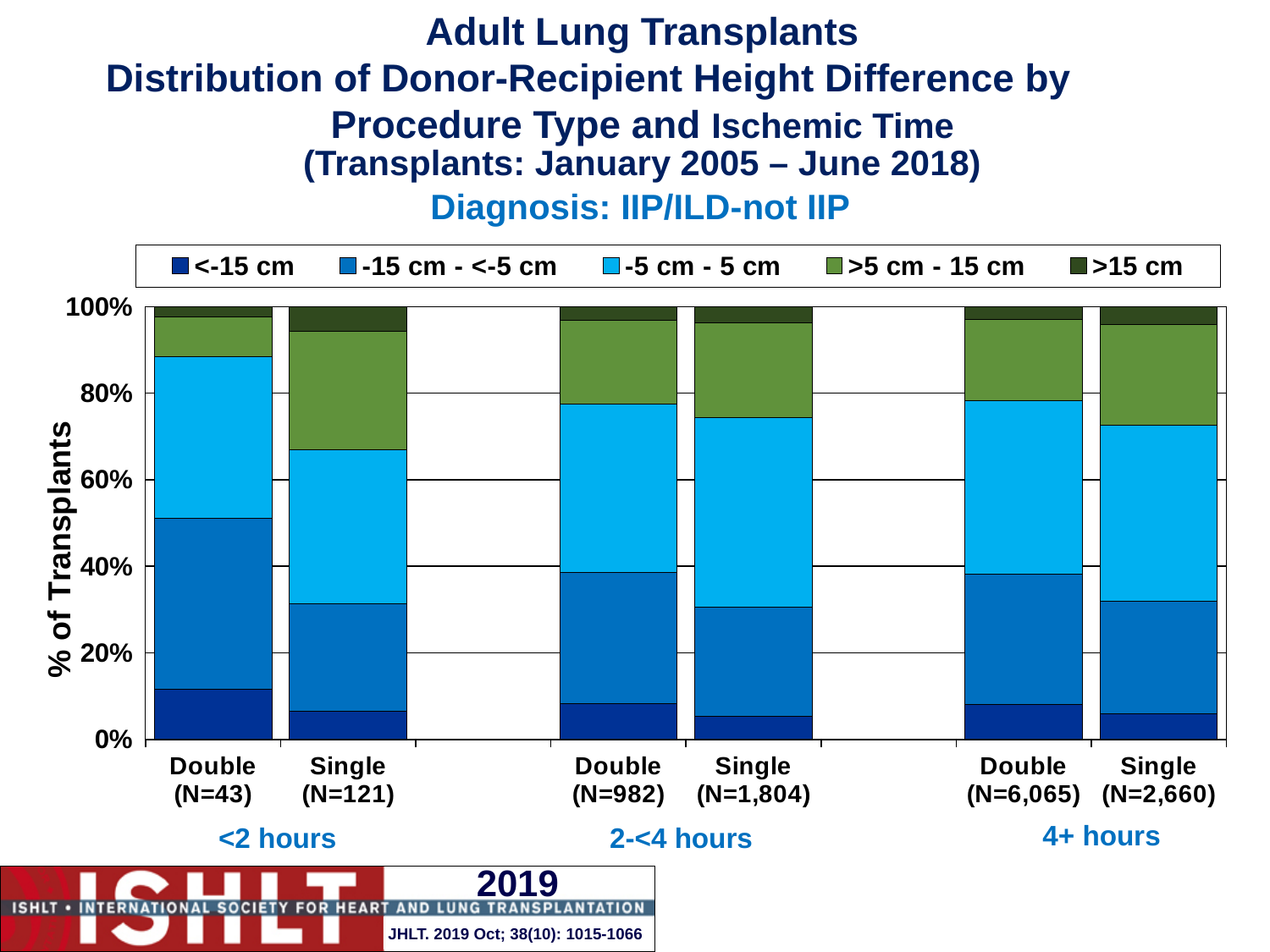
Which bar has the larger <-15 cm segment, Double (N=43) or Single (N=121)? Double (N=43) What diagnosis group does the chart cover? IIP/ILD-not IIP What kind of chart is shown on the slide? Stacked bar chart In the Double (N=6,065) bar, is the top of the -15 cm - <-5 cm segment greater or less than 40%? less What is the total of each stacked bar, as read from the y axis? 100% In the Double (N=43) bar, is the top of the <-15 cm segment greater or less than 20%? less In the Single (N=121) bar, is the boundary between the -5 cm - 5 cm and >5 cm - 15 cm segments greater or less than 60%? greater Which bar has the larger >5 cm - 15 cm segment, Double (N=43) or Single (N=121)? Single (N=121) What is the N for Single transplants in the 4+ hours group? 2,660 How many series does the legend list? 5 How many ischemic time groups are shown along the x axis? 3 How many bars are plotted in the chart? 6